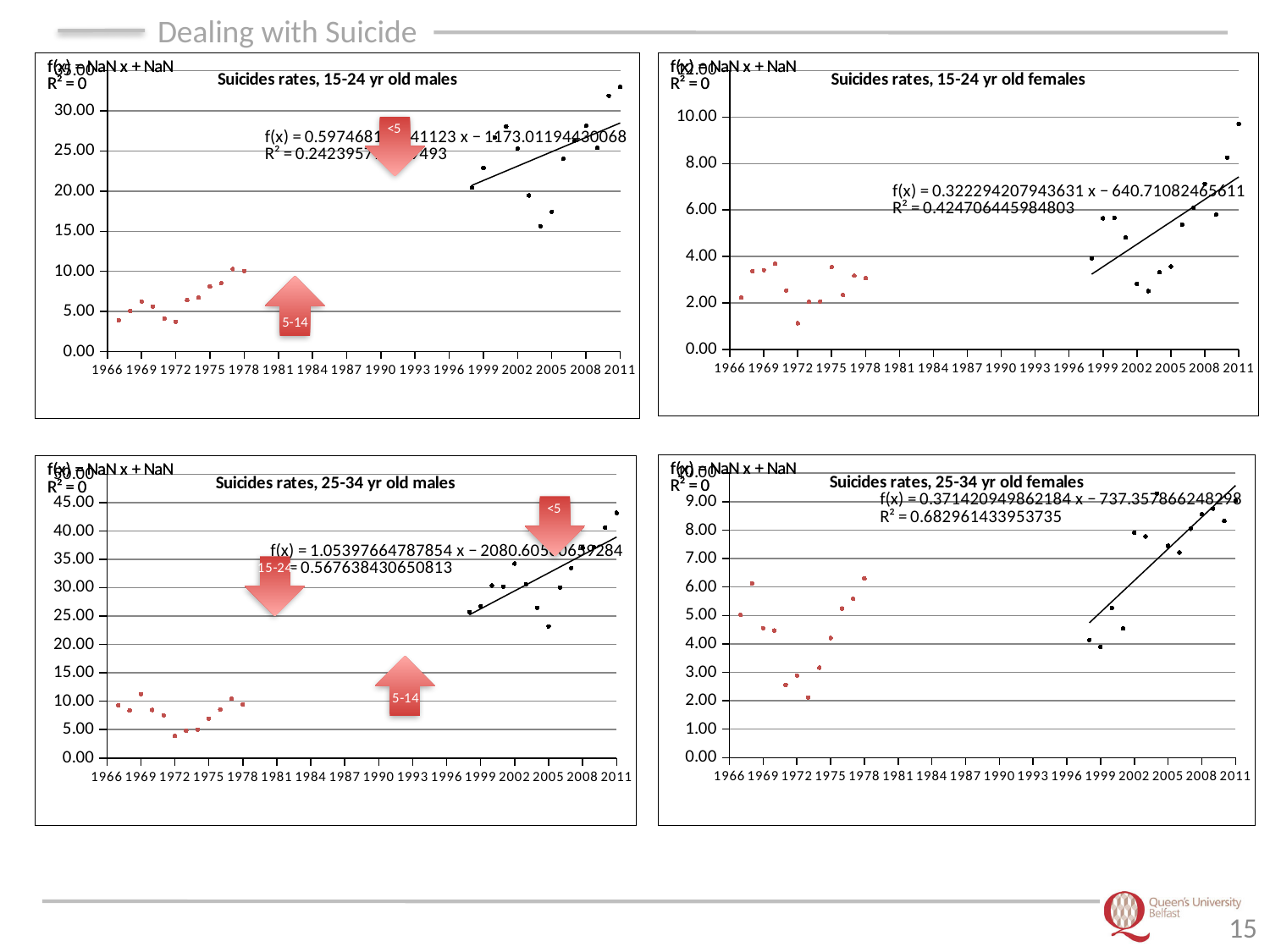
In the "Suicides rates, 25-34 yr old females" chart, is the value for 1972 greater or less than 3.00? less In the "Suicides rates, 25-34 yr old males" chart, is the value for 1972 greater or less than 10.00? less What R² value is printed on the "Suicides rates, 15-24 yr old females" chart? 0.424706445984803 How many charts are shown on the slide? 4 In the "Suicides rates, 25-34 yr old males" chart, is the value for 2011 greater or less than 40.00? greater In the "Suicides rates, 25-34 yr old females" chart, do the values generally rise or fall from 1966 to 2011? rise In the "Suicides rates, 25-34 yr old males" chart, do the values generally rise or fall from 1966 to 2011? rise What kind of chart is "Suicides rates, 15-24 yr old males"? scatter chart